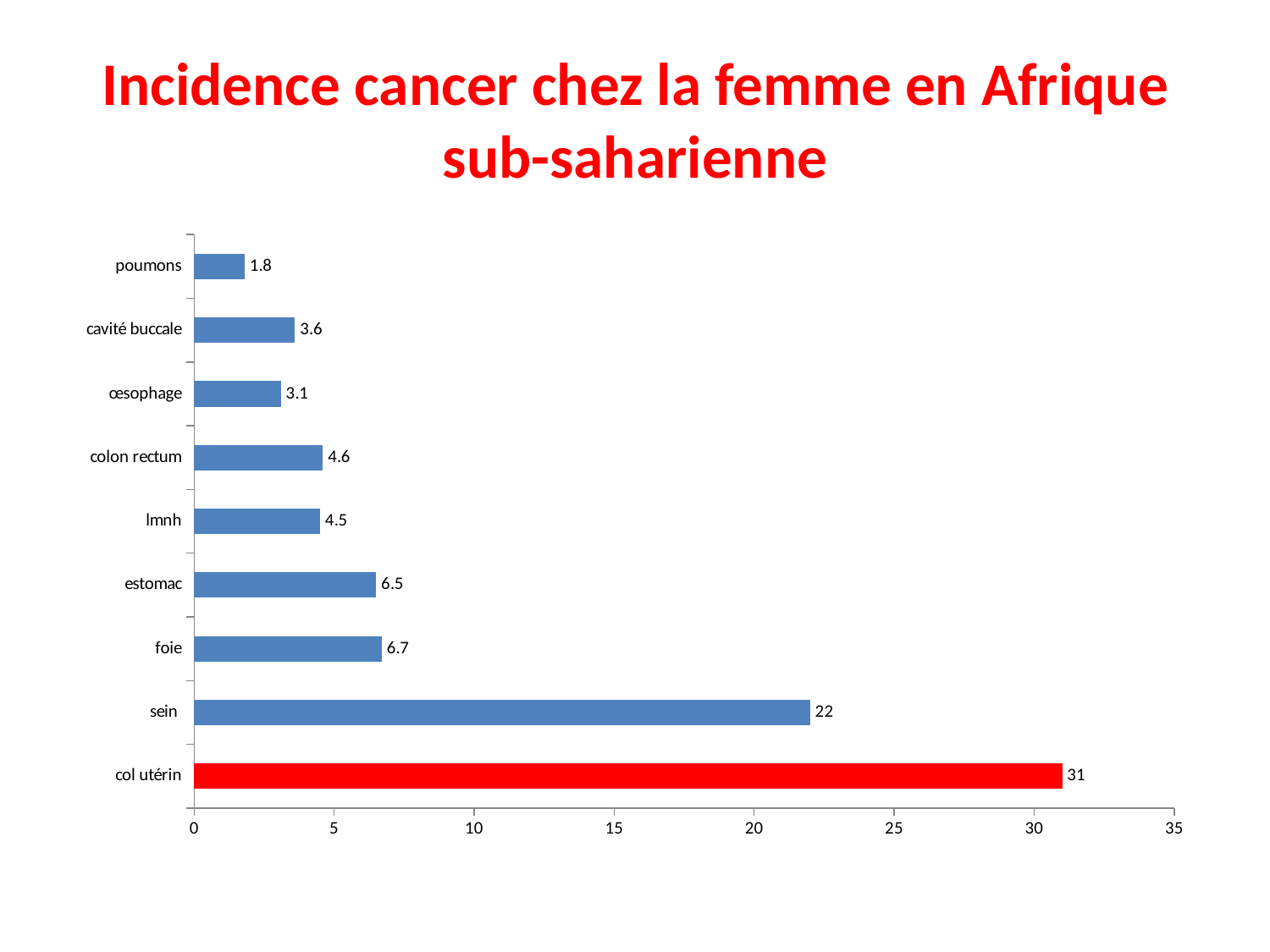
Which category has the highest value? col utérin How many categories are shown in the chart? 9 Is the value for sein greater or less than 20? greater What is the difference between the values for col utérin and sein? 9 Which is larger, the value for estomac or the value for foie? foie What kind of chart is shown on the slide? bar chart What is the title of the slide? Incidence cancer chez la femme en Afrique sub-saharienne What is the value for col utérin? 31 What is the value for poumons? 1.8 What is the value for sein? 22 Which bar is coloured red? col utérin Which category has the lowest value? poumons